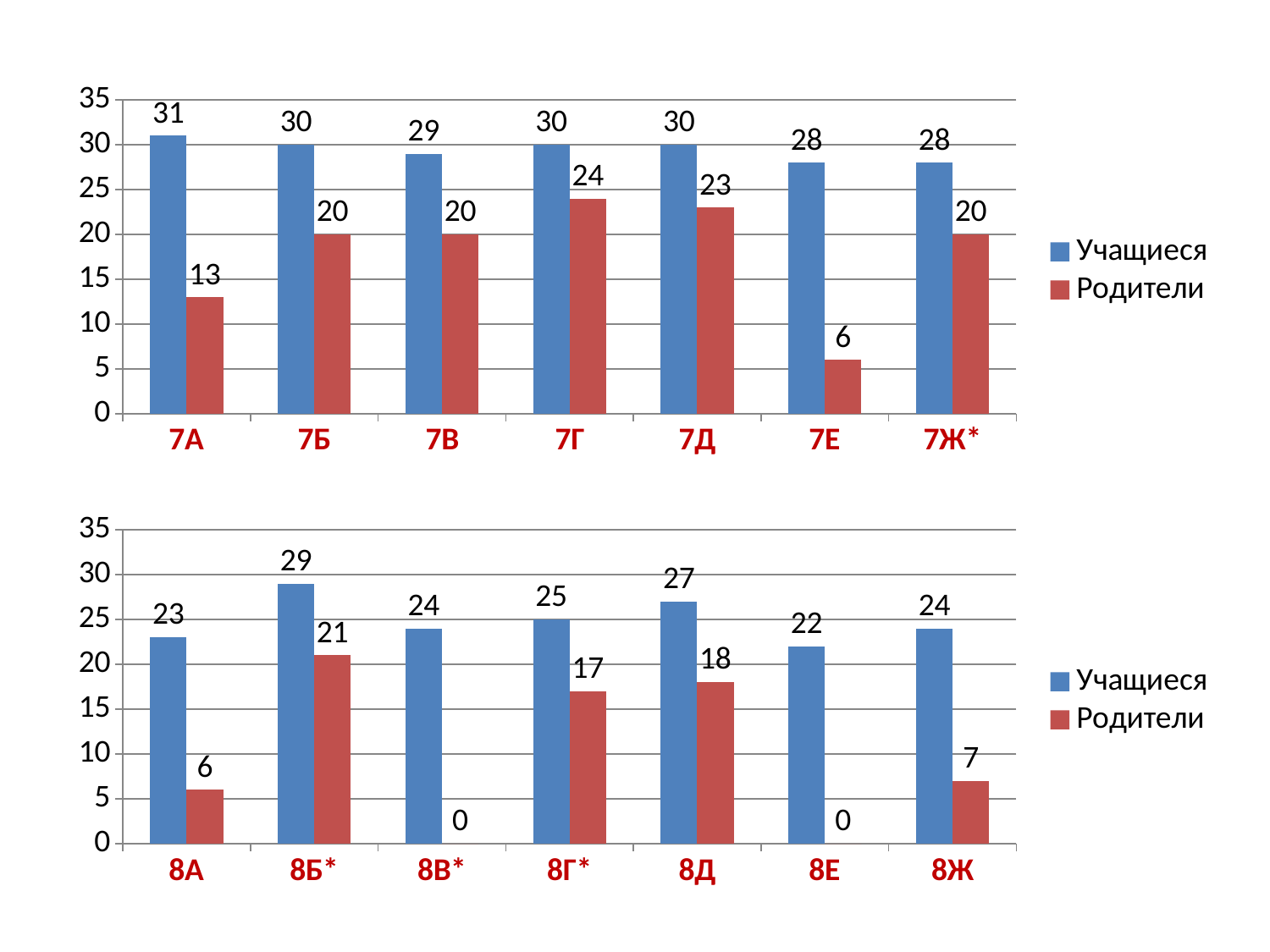
In the top chart, what is the value for Родители in 7Г? 24 In the top chart, which category has the lowest value for Родители? 7Е In the top chart, what is the value for Учащиеся in 7А? 31 In the bottom chart, is the value for Родители in 8Д larger or smaller than the value for Родители in 8Г*? larger In the bottom chart, which category has the lowest value for Учащиеся? 8Е In the top chart, which category has the highest value for Учащиеся? 7А In the bottom chart, what is the difference between Учащиеся and Родители in 8А? 17 How many series does the legend of the bottom chart list? 2 In the top chart, what is the difference between Учащиеся and Родители in 7Е? 22 In the top chart, how many categories are shown on the x axis? 7 In the bottom chart, which category has the highest value for Учащиеся? 8Б* In the bottom chart, what is the value for Родители in 8Б*? 21